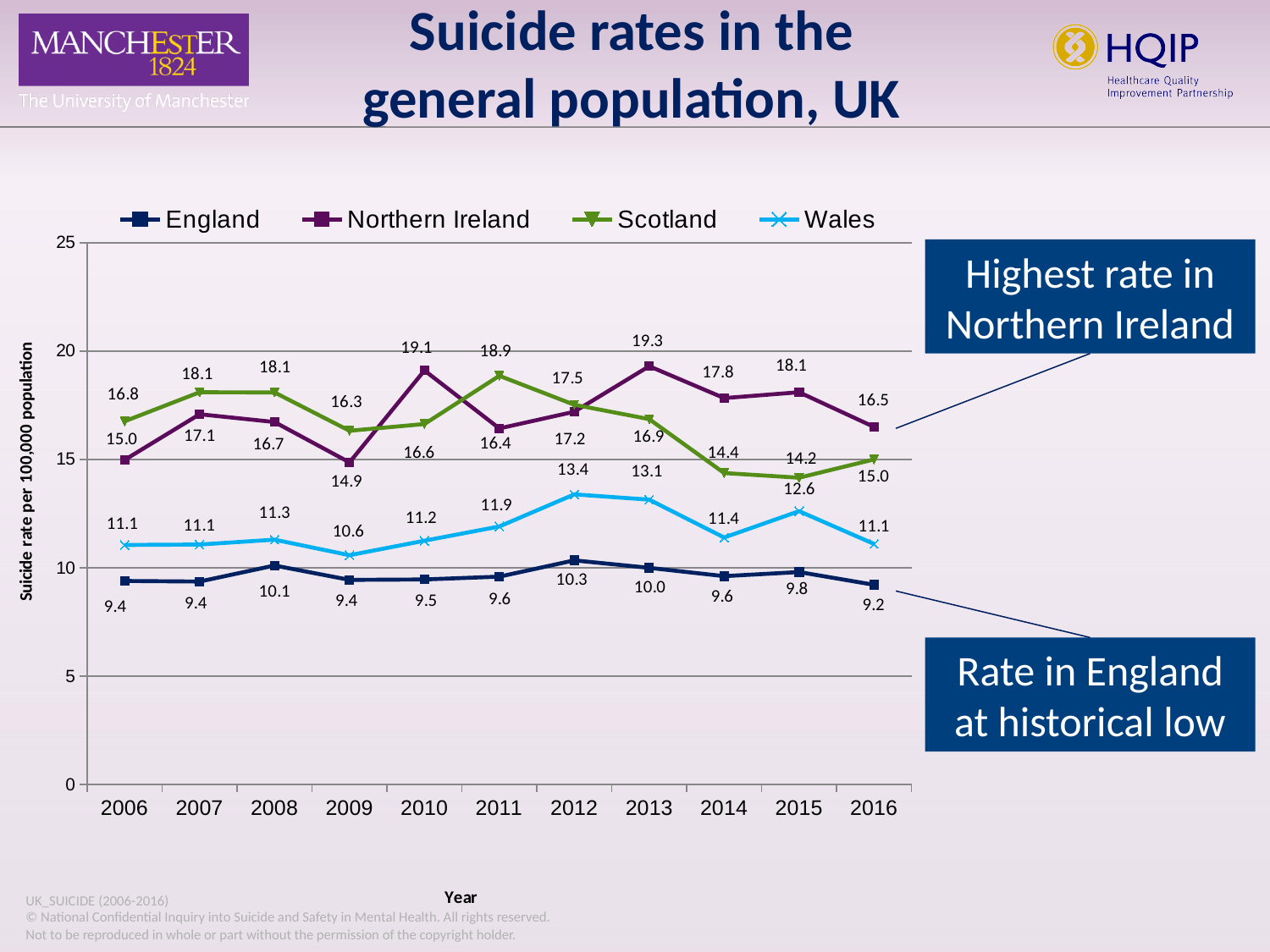
How many series does the legend list? 4 What is the suicide rate for Wales in 2012? 13.4 What type of chart is shown on the slide? Line chart What is the label on the y axis? Suicide rate per 100,000 population Did the Scotland rate rise or fall from 2013 to 2015? Fall In 2011, which had the higher rate, Scotland or Northern Ireland? Scotland In which year was the Northern Ireland rate highest? 2013 What is the suicide rate for Northern Ireland in 2013? 19.3 What is the suicide rate for England in 2016? 9.2 What is the difference between the Northern Ireland and England rates in 2016? 7.3 How many years are plotted along the x axis? 11 In which year was the England rate lowest? 2016